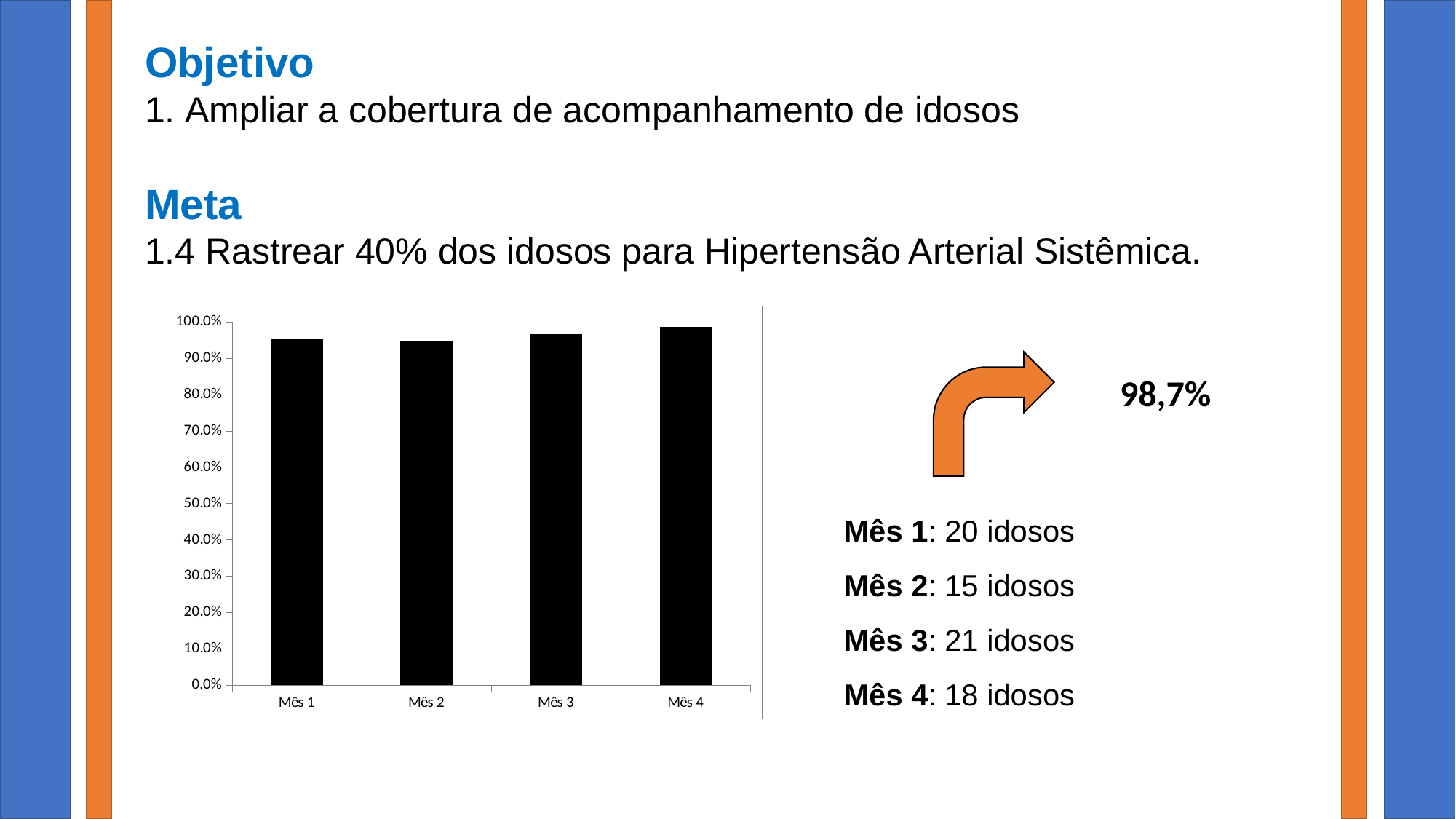
Is the value for Mês 4 greater or less than 50.0%? greater How many categories (months) are plotted in the chart? 4 Which is larger, the value for Mês 4 or the value for Mês 1? Mês 4 Which month has the highest bar in the chart? Mês 4 Is the value for Mês 2 greater or less than 90.0%? greater What kind of chart is shown on the slide? bar chart What colour are the bars in the chart? black Which is larger, the value for Mês 3 or the value for Mês 2? Mês 3 Is the value for Mês 3 greater or less than 80.0%? greater What is the highest value shown on the chart's vertical axis? 100.0%